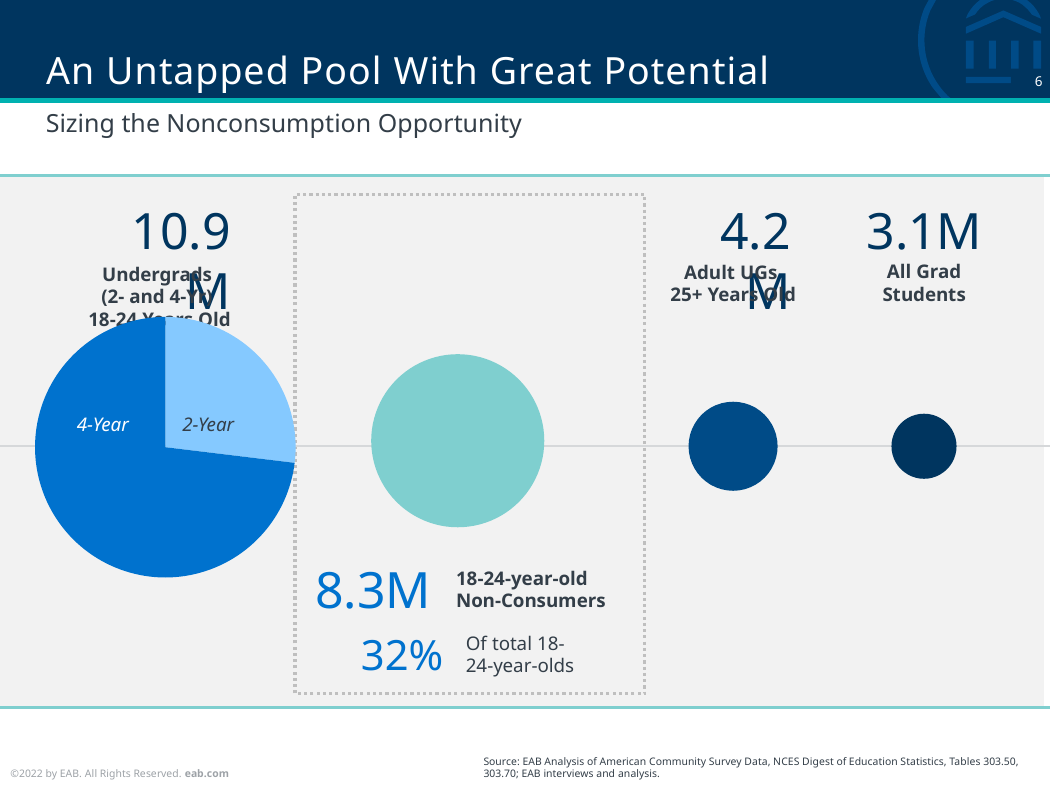
Which of the four labelled groups on the slide has the largest value? Undergrads (2- and 4-Yr) 18-24 Years Old In the pie chart on the left, which slice is the smallest? 2-Year What share of total 18-24-year-olds do the 18-24-year-old Non-Consumers represent? 32% What value is shown for 18-24-year-old Non-Consumers? 8.3M What is the difference between the value for Adult UGs 25+ Years Old and the value for All Grad Students? 1.1M What value is shown for Undergrads (2- and 4-Yr) 18-24 Years Old? 10.9M How many slices does the pie chart on the left have? 2 In the pie chart on the left, which slice is larger, 4-Year or 2-Year? 4-Year What value is shown for All Grad Students? 3.1M What value is shown for Adult UGs 25+ Years Old? 4.2M Which of the four labelled groups on the slide has the smallest value? All Grad Students What kind of chart is shown on the left of the slide, with the 4-Year and 2-Year slices? pie chart